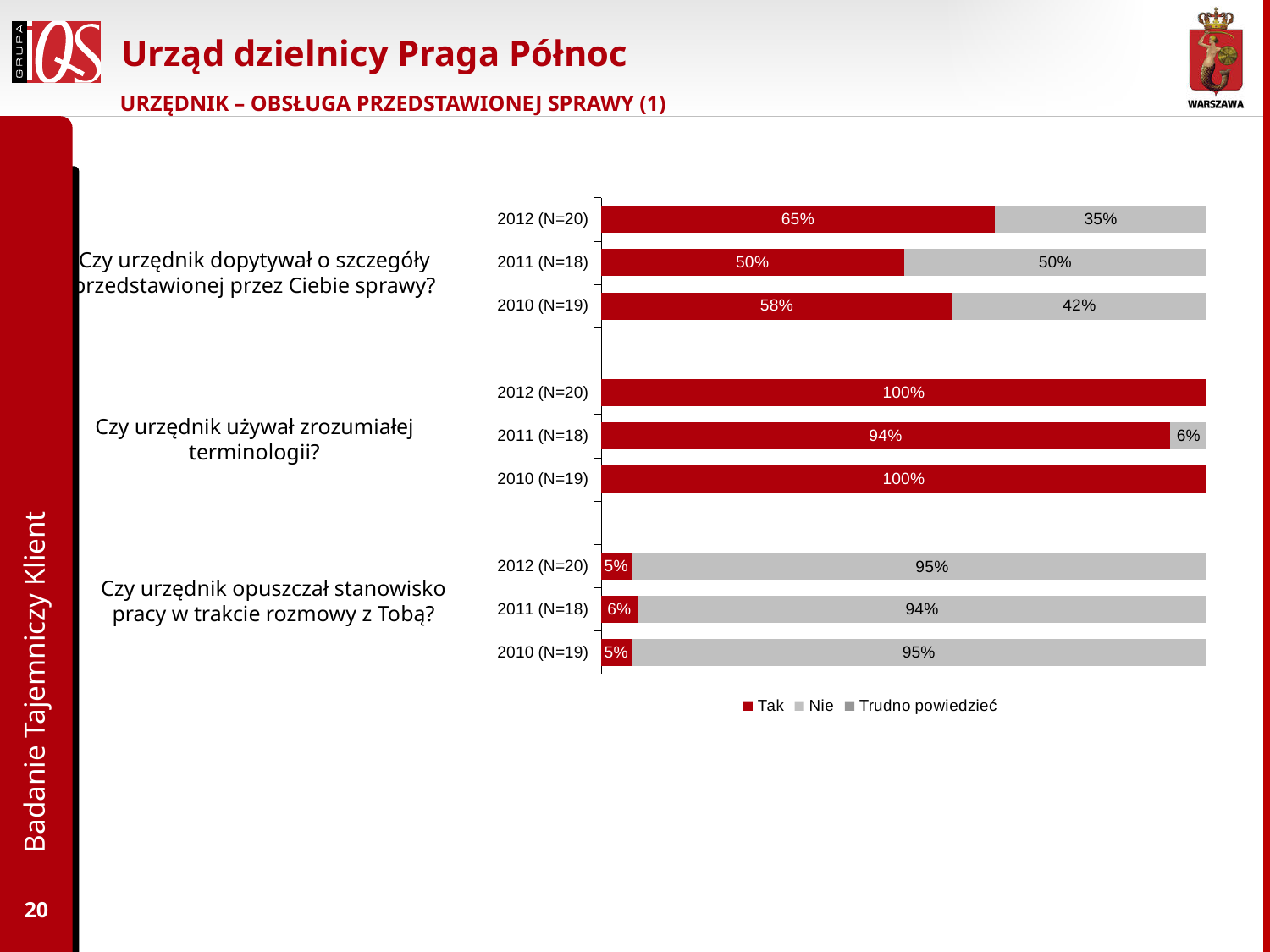
What type of chart is shown on the slide? Stacked bar chart For the question 'Czy urzędnik dopytywał o szczegóły przedstawionej przez Ciebie sprawy?', which year has the highest 'Tak' share? 2012 (N=20) For the question 'Czy urzędnik dopytywał o szczegóły przedstawionej przez Ciebie sprawy?', what is the 'Tak' value for 2012 (N=20)? 65% For the question 'Czy urzędnik opuszczał stanowisko pracy w trakcie rozmowy z Tobą?', what is the 'Nie' value for 2011 (N=18)? 94% For the question 'Czy urzędnik używał zrozumiałej terminologii?', what is the 'Tak' value for 2011 (N=18)? 94% How many year bars are shown for the question 'Czy urzędnik opuszczał stanowisko pracy w trakcie rozmowy z Tobą?'? 3 For the question 'Czy urzędnik dopytywał o szczegóły przedstawionej przez Ciebie sprawy?', what is the 'Nie' value for 2010 (N=19)? 42% For the question 'Czy urzędnik dopytywał o szczegóły przedstawionej przez Ciebie sprawy?', what is the difference between the 'Tak' values for 2012 (N=20) and 2010 (N=19)? 7 percentage points For the question 'Czy urzędnik dopytywał o szczegóły przedstawionej przez Ciebie sprawy?', which year has the lowest 'Tak' share? 2011 (N=18) How many series does the legend list? 3 What are the legend entries of the chart? Tak, Nie, Trudno powiedzieć For the question 'Czy urzędnik używał zrozumiałej terminologii?', is the 'Tak' value for 2012 (N=20) larger or smaller than for 2011 (N=18)? Larger